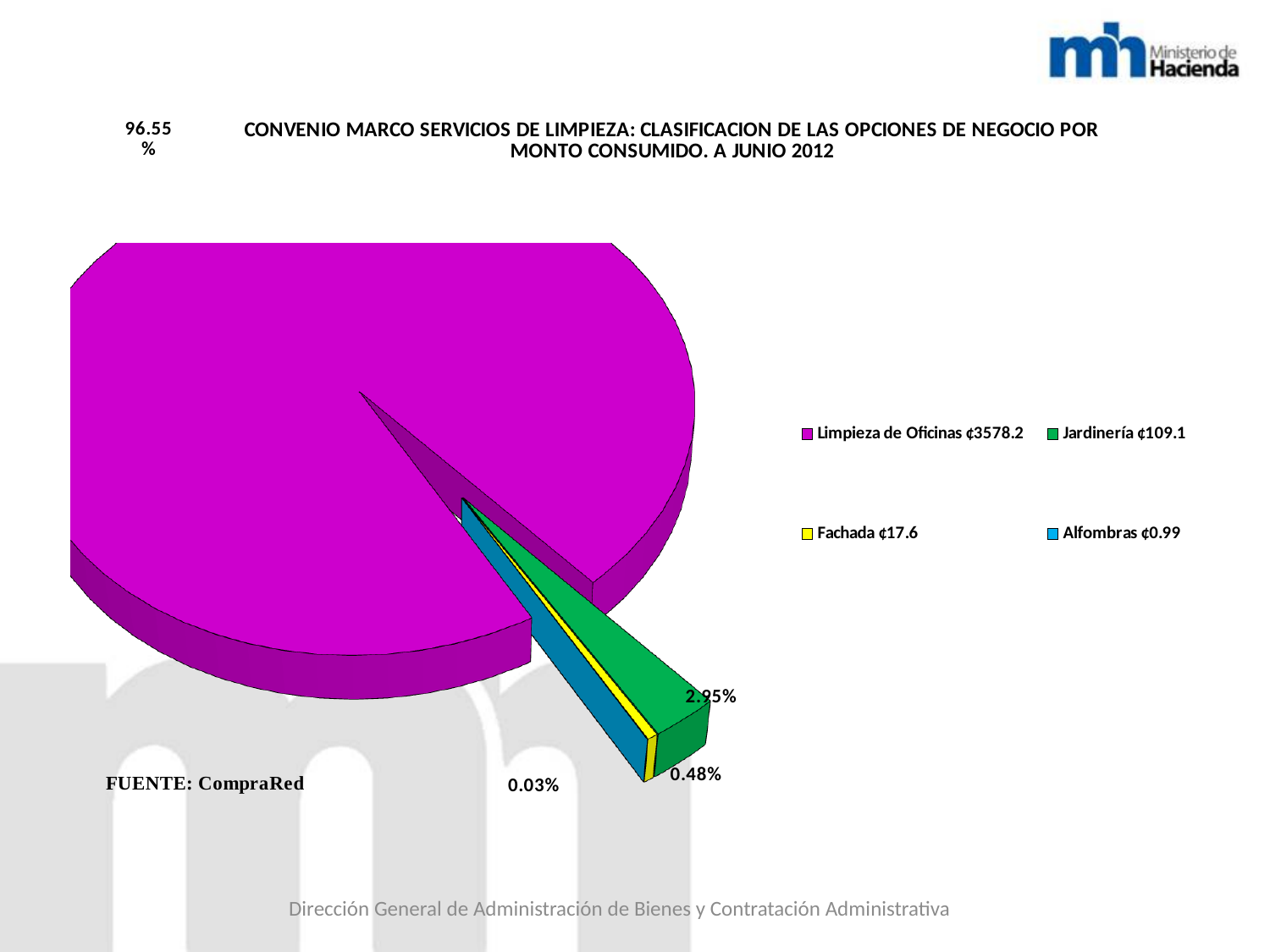
Which category has the largest slice of the pie? Limpieza de Oficinas What is the difference in percentage points between the Limpieza de Oficinas share and the Jardinería share? 93.60% What share of the pie does Fachada represent? 0.48% What share of the pie does Jardinería represent? 2.95% What amount is shown in the legend for Jardinería? ¢109.1 How many slices does the pie chart have? 4 What kind of chart is shown on the slide? Pie chart Which category has the smallest slice of the pie? Alfombras What amount is shown in the legend for Limpieza de Oficinas? ¢3578.2 Which is larger, the share for Jardinería or the share for Fachada? Jardinería What share of the pie does Limpieza de Oficinas represent? 96.55%